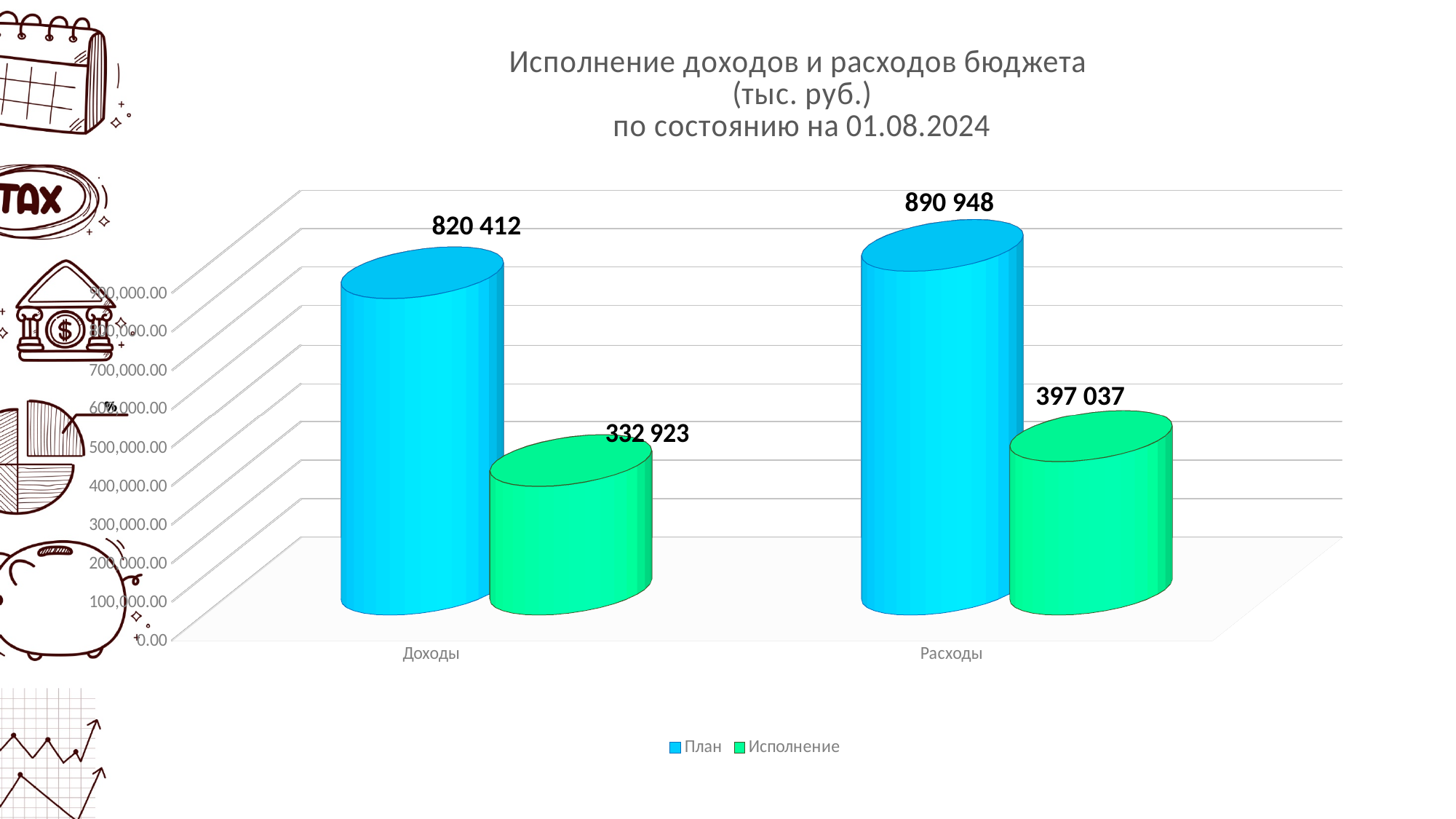
What is the difference between the План and Исполнение values for Доходы? 487 489 What is the Исполнение value for Доходы? 332 923 Which is larger: the Исполнение value for Доходы or the Исполнение value for Расходы? Исполнение for Расходы How many categories are shown on the x axis? 2 How many series does the legend list? 2 Which bar has the lowest value on the chart? Исполнение for Доходы What is the difference between the План values for Расходы and Доходы? 70 536 Which category has the higher План value? Расходы What is the Исполнение value for Расходы? 397 037 What is the План value for Доходы? 820 412 What type of chart is shown on the slide? Bar chart What is the План value for Расходы? 890 948